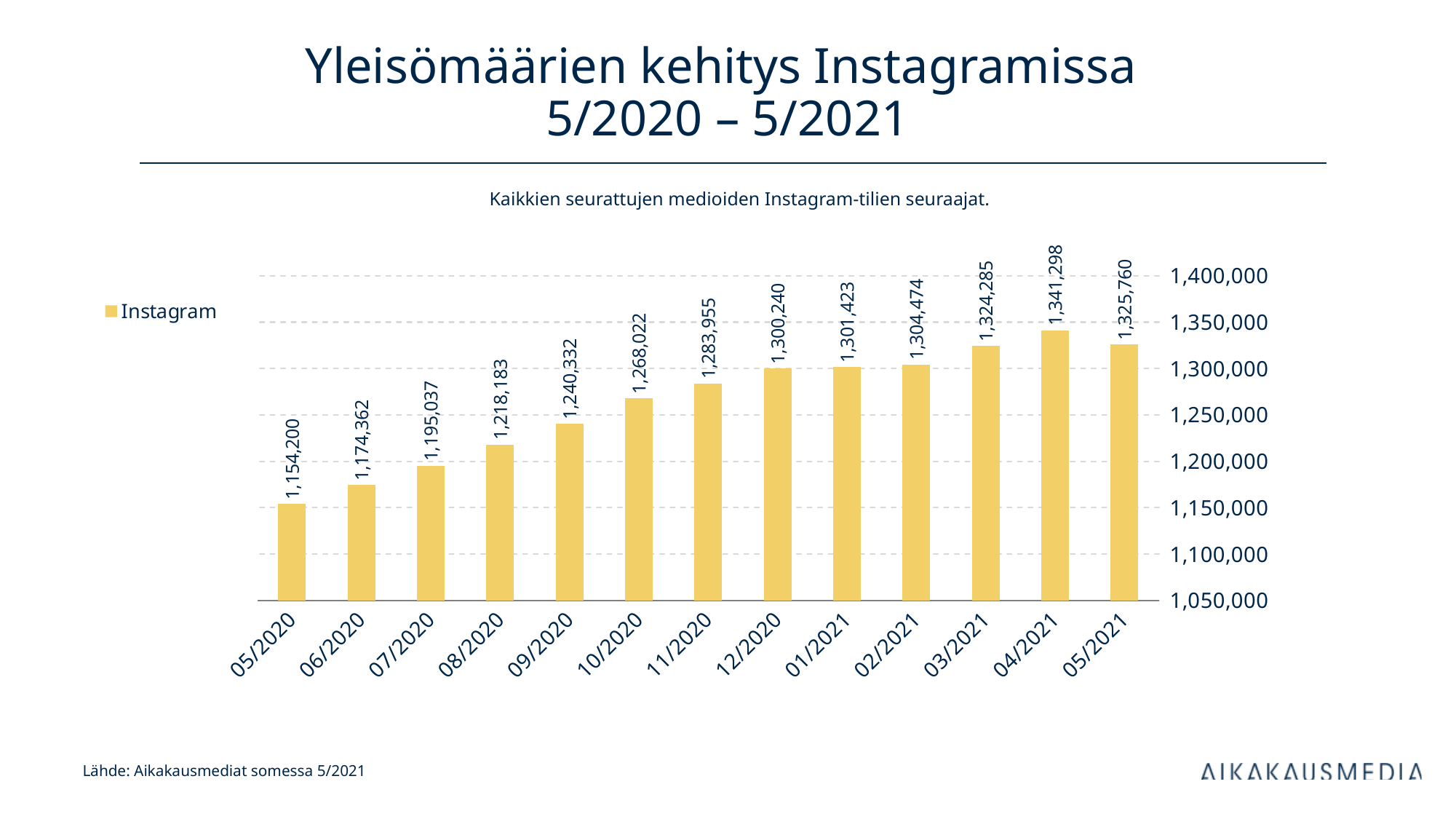
What is the value for 05/2020? 1,154,200 What kind of chart is shown on the slide? bar chart What is the value for 12/2020? 1,300,240 What is the difference between the values for 05/2021 and 05/2020? 171,560 Which month has the highest value? 04/2021 What is the value for 05/2021? 1,325,760 How many months are shown on the x axis? 13 Do the values generally rise or fall from 05/2020 to 04/2021? rise What is the difference between the values for 04/2021 and 05/2021? 15,538 Which is larger, the value for 09/2020 or the value for 10/2020? 10/2020 Is the value for 08/2020 greater or less than 1,200,000? greater Which month has the lowest value? 05/2020